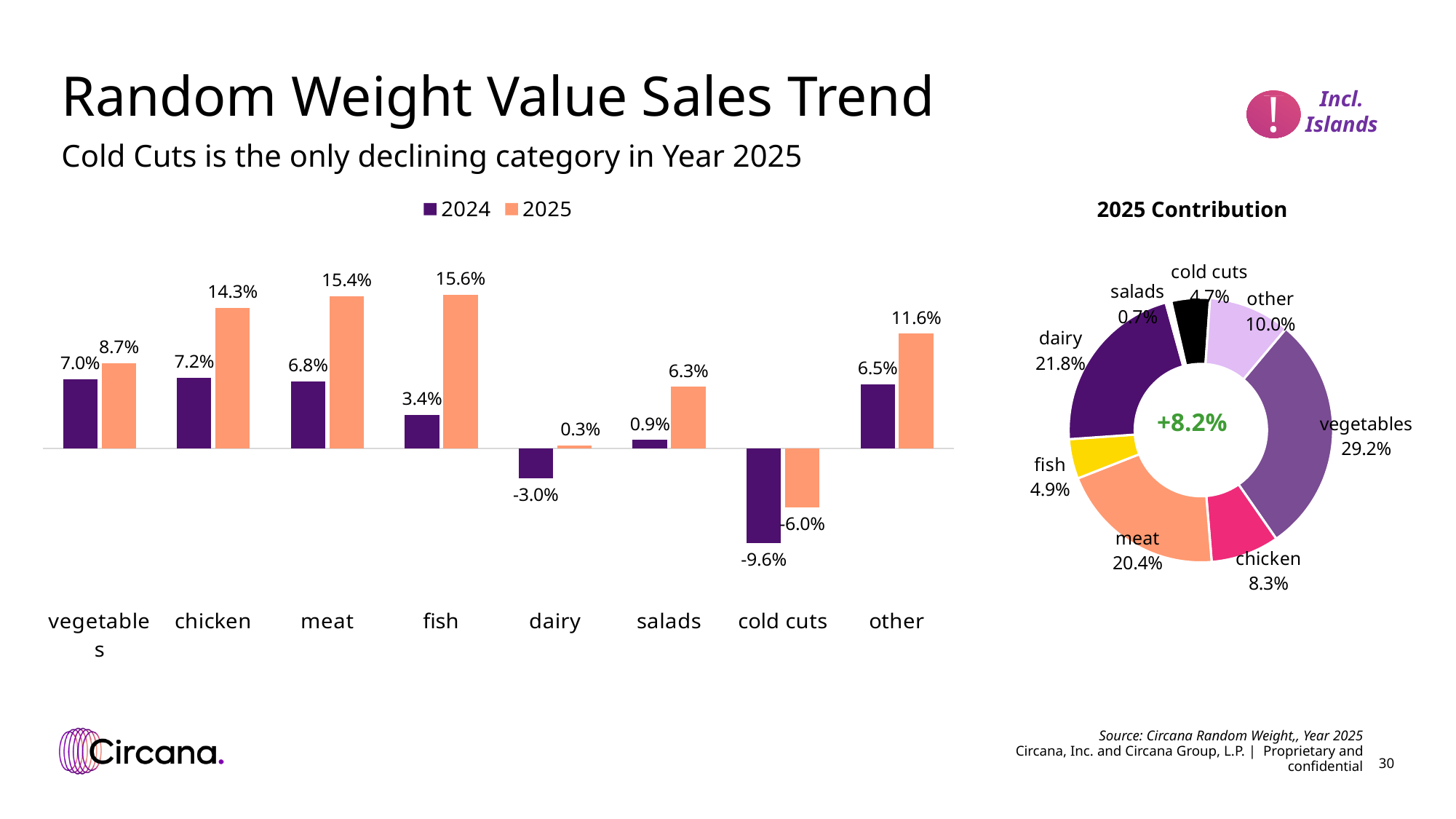
In the 2025 Contribution chart, which category has the smallest share? salads In the bar chart on the left, which category has the lowest 2024 value? cold cuts How many categories are shown on the x axis of the bar chart on the left? 8 How many series does the legend of the bar chart on the left list? 2 What kind of chart is the chart on the left? bar chart What value is shown in the centre of the 2025 Contribution chart? +8.2% In the bar chart on the left, what is the difference between the 2025 and 2024 values for chicken? 7.1% In the bar chart on the left, what is the 2025 value for fish? 15.6% In the 2025 Contribution chart, what share does vegetables have? 29.2% In the bar chart on the left, which category has the highest 2025 value? fish In the bar chart on the left, which is larger for dairy: the 2024 value or the 2025 value? 2025 In the bar chart on the left, what is the 2024 value for cold cuts? -9.6%